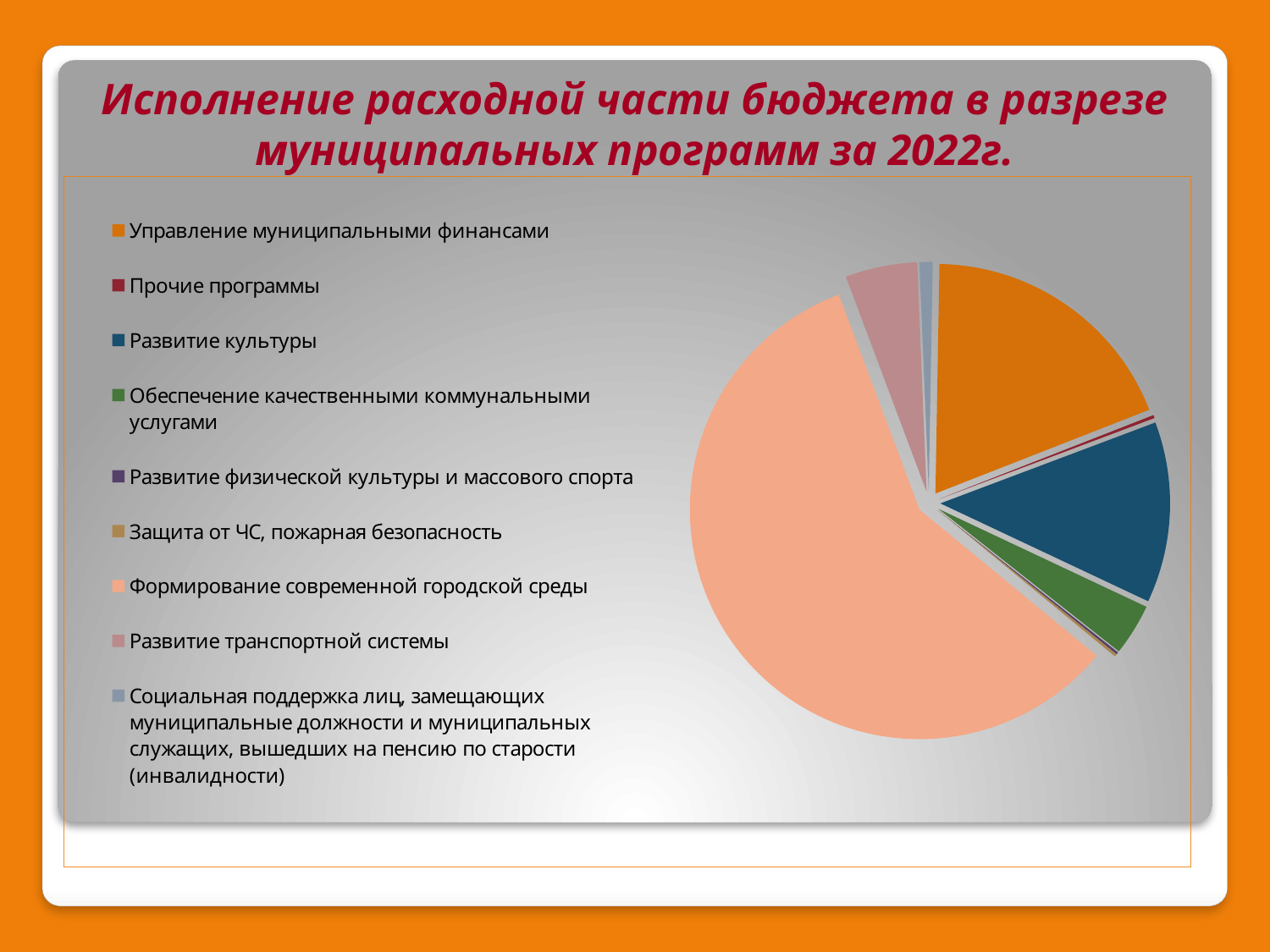
Which slice is larger: Формирование современной городской среды or Управление муниципальными финансами? Формирование современной городской среды Which slice is larger: Развитие транспортной системы or Социальная поддержка лиц, замещающих муниципальные должности и муниципальных служащих, вышедших на пенсию по старости (инвалидности)? Развитие транспортной системы What kind of chart is shown on the slide? Pie chart What is the title of the slide containing the pie chart? Исполнение расходной части бюджета в разрезе муниципальных программ за 2022г. Which slice is larger: Обеспечение качественными коммунальными услугами or Развитие транспортной системы? Развитие транспортной системы Which category has the largest slice of the pie chart? Формирование современной городской среды What colour is the slice for Развитие культуры in the pie chart? Dark blue How many categories does the legend of the pie chart list? 9